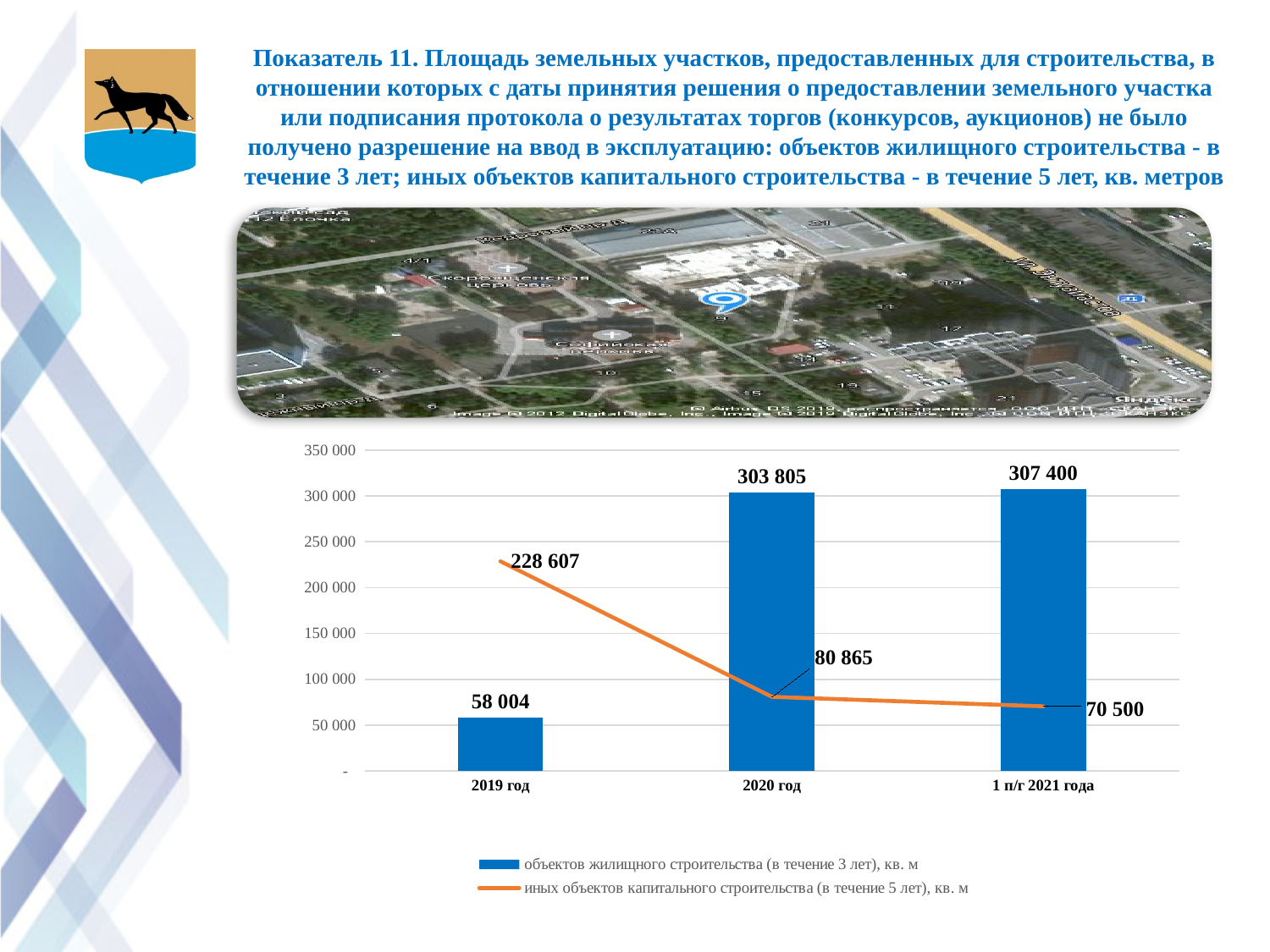
What is the value of the line series (иных объектов капитального строительства) for 2019 год? 228 607 What is the value of the bar series (объектов жилищного строительства) for 2020 год? 303 805 Which category has the lowest value for the line series (иных объектов капитального строительства)? 1 п/г 2021 года What is the difference between the bar values for 2020 год and 2019 год? 245 801 Does the line series (иных объектов капитального строительства) rise or fall from 2019 год to 1 п/г 2021 года? fall Which category has the highest value for the bar series (объектов жилищного строительства)? 1 п/г 2021 года How many categories are shown on the x axis? 3 Which is larger in 2020 год: the bar value (объектов жилищного строительства) or the line value (иных объектов капитального строительства)? объектов жилищного строительства (303 805) What colour is the line series (иных объектов капитального строительства) in the chart? orange How many series does the legend list? 2 What is the value of the bar series (объектов жилищного строительства) for 2019 год? 58 004 What is the value of the line series (иных объектов капитального строительства) for 1 п/г 2021 года? 70 500